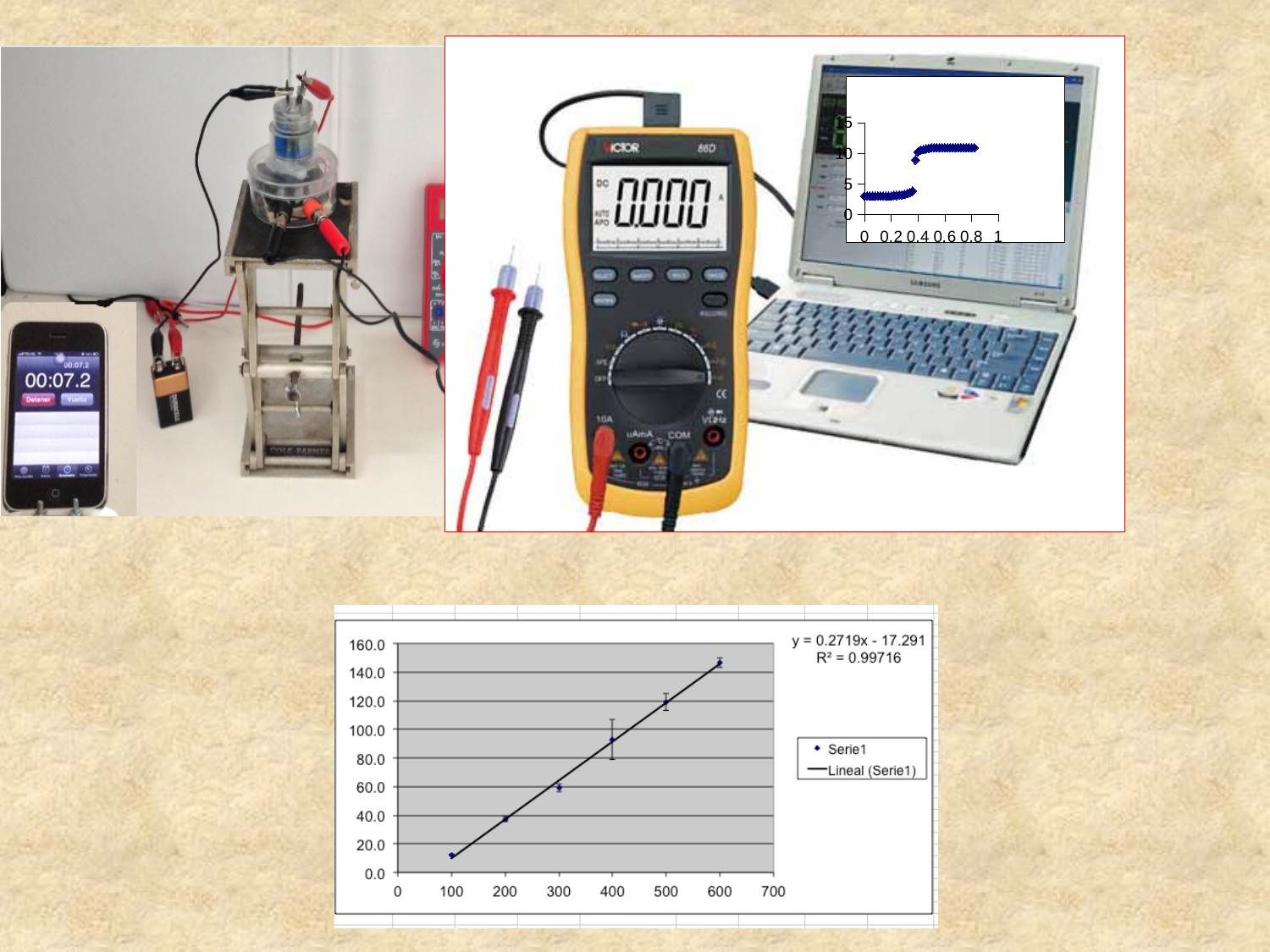
On the bottom chart, which x value has the lowest Serie1 value? 100 On the bottom chart, is the value for x = 600 greater or less than 140.0? greater On the bottom chart, is the value for x = 100 greater or less than 20.0? less On the bottom chart, how many series does the legend list? 2 On the bottom chart, what kind of chart is it? scatter chart On the bottom chart, do the Serie1 values rise or fall as x increases from 100 to 600? rise On the bottom chart, what is the trendline equation shown? y = 0.2719x - 17.291 On the bottom chart, is the value for x = 400 greater or less than 80.0? greater On the bottom chart, how many data points are plotted for Serie1? 6 On the bottom chart, what R² value is shown? R² = 0.99716 On the bottom chart, what are the two legend entries? Serie1 and Lineal (Serie1) On the bottom chart, which x value has the highest Serie1 value? 600